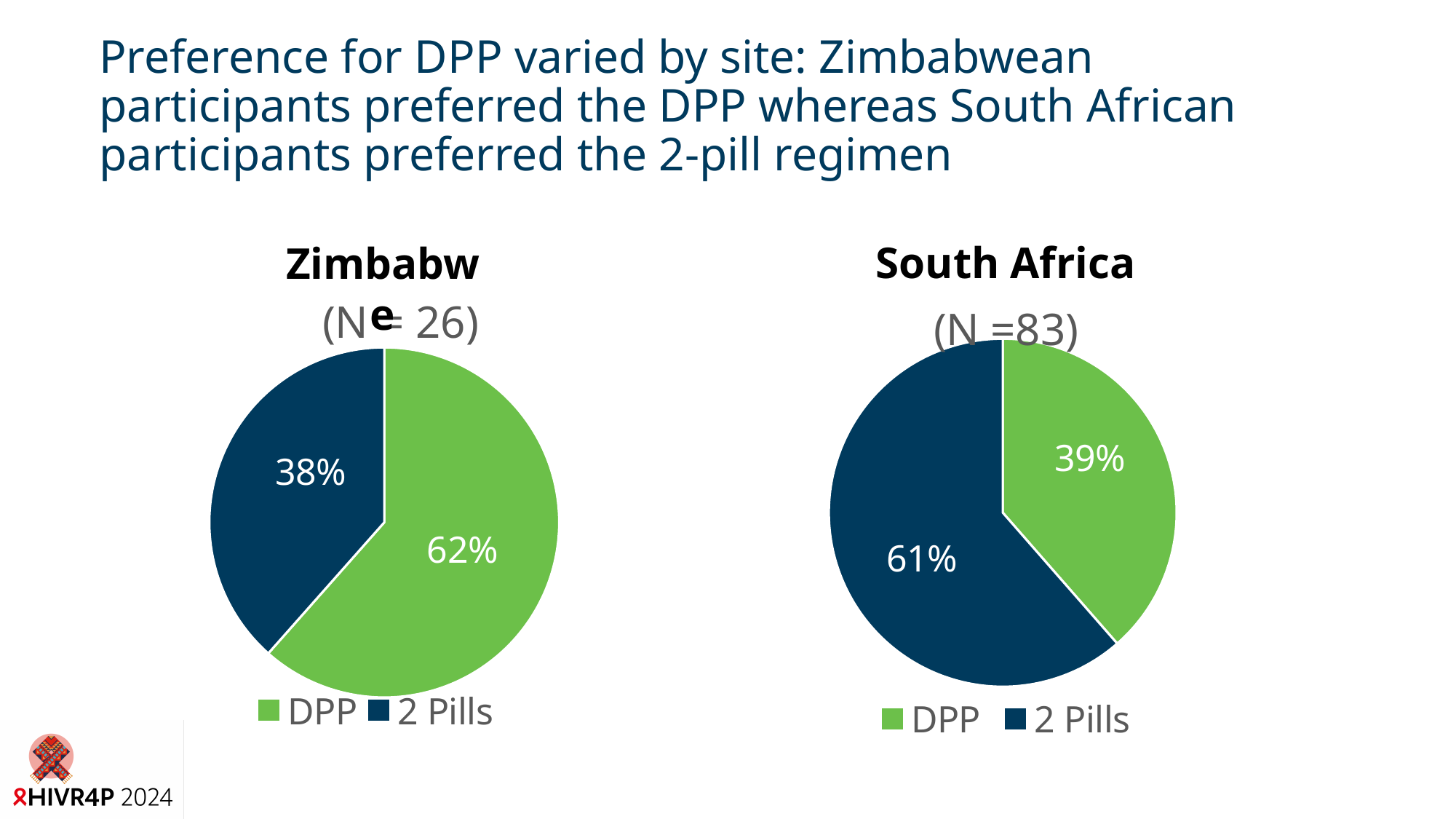
In the Zimbabwe pie chart, what percentage of participants preferred DPP? 62% In the South Africa pie chart, what is the difference in percentage points between the 2 Pills and DPP shares? 22 In the South Africa pie chart, what percentage of participants preferred 2 Pills? 61% In the South Africa pie chart, what percentage of participants preferred DPP? 39% Is the DPP share larger in the Zimbabwe chart or the South Africa chart? Zimbabwe In the Zimbabwe pie chart, which option has the larger share? DPP What colour represents 2 Pills in the legend of the South Africa chart? Dark blue In the Zimbabwe pie chart, what is the difference in percentage points between the DPP and 2 Pills shares? 24 In the South Africa pie chart, which option has the smaller share? DPP How many slices does the Zimbabwe pie chart have? 2 What type of chart is used for the South Africa data? Pie chart In the Zimbabwe pie chart, what percentage of participants preferred 2 Pills? 38%